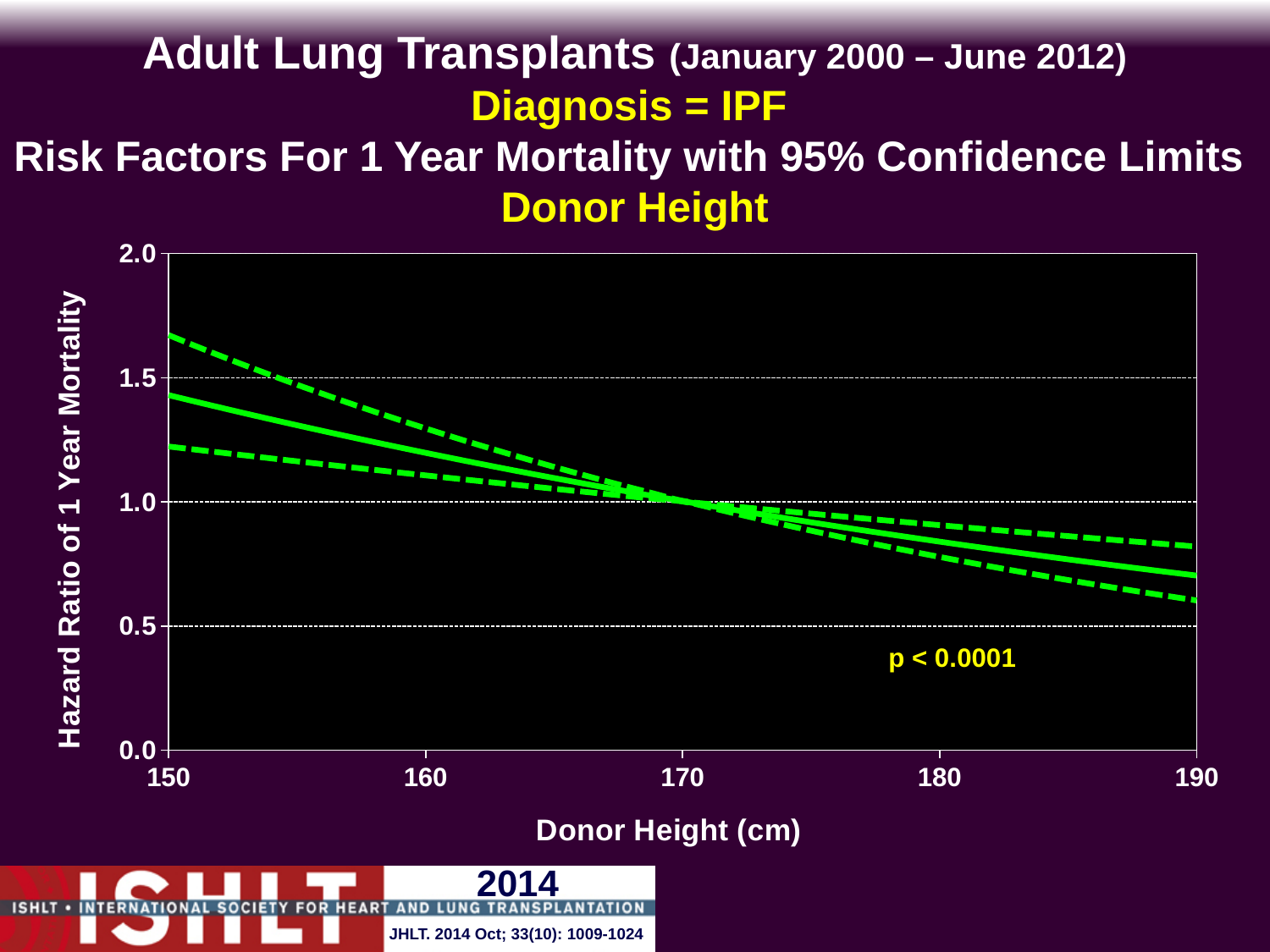
Is the lower 95% confidence limit (lower dashed line) at a donor height of 190 cm greater or less than 0.5? greater Is the upper 95% confidence limit (upper dashed line) at a donor height of 150 cm greater or less than 1.5? greater What kind of chart is shown on the slide? line chart Does the hazard ratio of 1 year mortality rise or fall as donor height increases from 150 cm to 190 cm? fall Is the hazard ratio (solid line) at a donor height of 190 cm greater or less than 1.0? less What p-value is printed on the chart? p < 0.0001 What is the label of the x axis? Donor Height (cm) How many tick labels are shown on the x axis of the chart? 5 Which donor height has the larger hazard ratio on the solid line, 160 cm or 180 cm? 160 cm